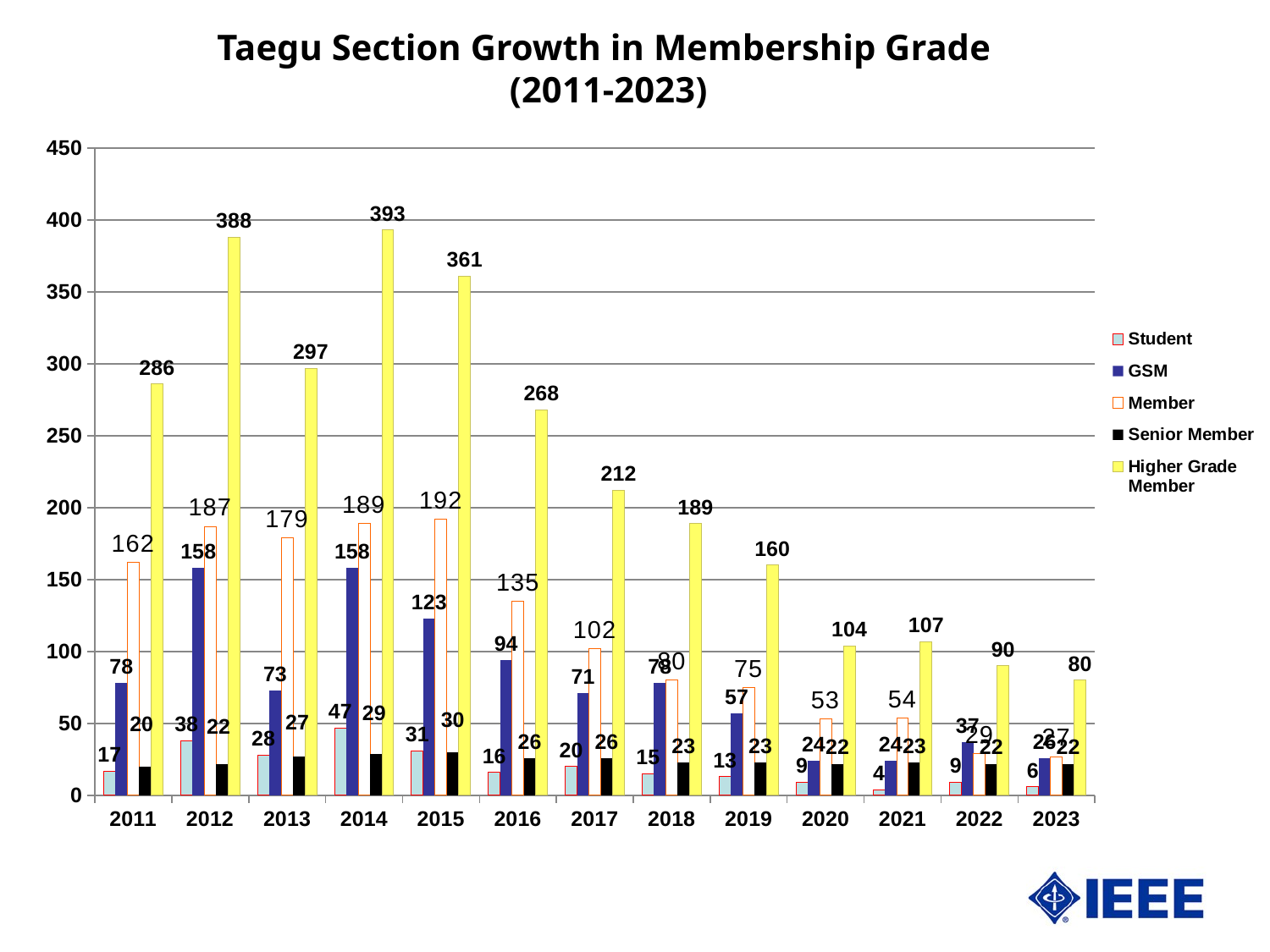
What is the value for Higher Grade Member in 2014? 393 What kind of chart is shown on the slide? bar chart Which is larger in 2011, the Member value or the GSM value? Member How many series does the legend list? 5 In which year is the Student value lowest? 2021 What is the Senior Member value in 2015? 30 Do the Higher Grade Member values rise or fall from 2014 to 2023? fall In which year is the Higher Grade Member value highest? 2014 What is the Student value in 2021? 4 What is the difference between the Higher Grade Member values in 2012 and 2011? 102 How many years are shown on the x axis? 13 What is the Member value in 2015? 192